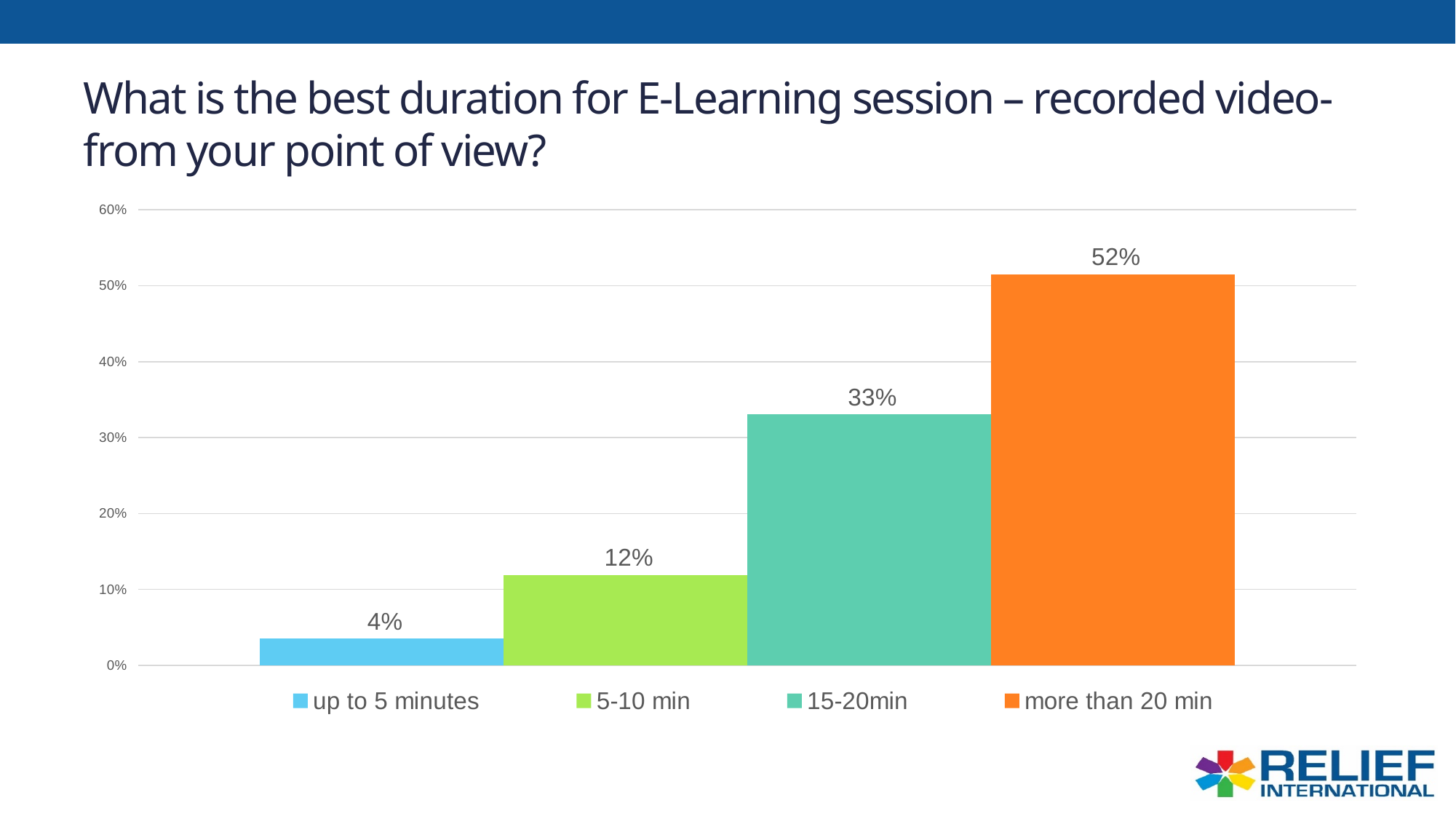
Do the values rise or fall from left to right across the duration options? rise What is the value shown for 'up to 5 minutes'? 4% What is the value shown for '5-10 min'? 12% Which duration option has the lowest value? up to 5 minutes What kind of chart is shown on the slide? bar chart How many duration options are shown in the chart? 4 Which is larger, the value for '5-10 min' or the value for '15-20min'? 15-20min What is the difference in percentage points between 'more than 20 min' and '15-20min'? 19 What is the value shown for '15-20min'? 33% Which duration option has the highest value? more than 20 min What percentage of respondents chose 'more than 20 min' as the best duration? 52% Is the value for 'more than 20 min' greater or less than 50%? greater